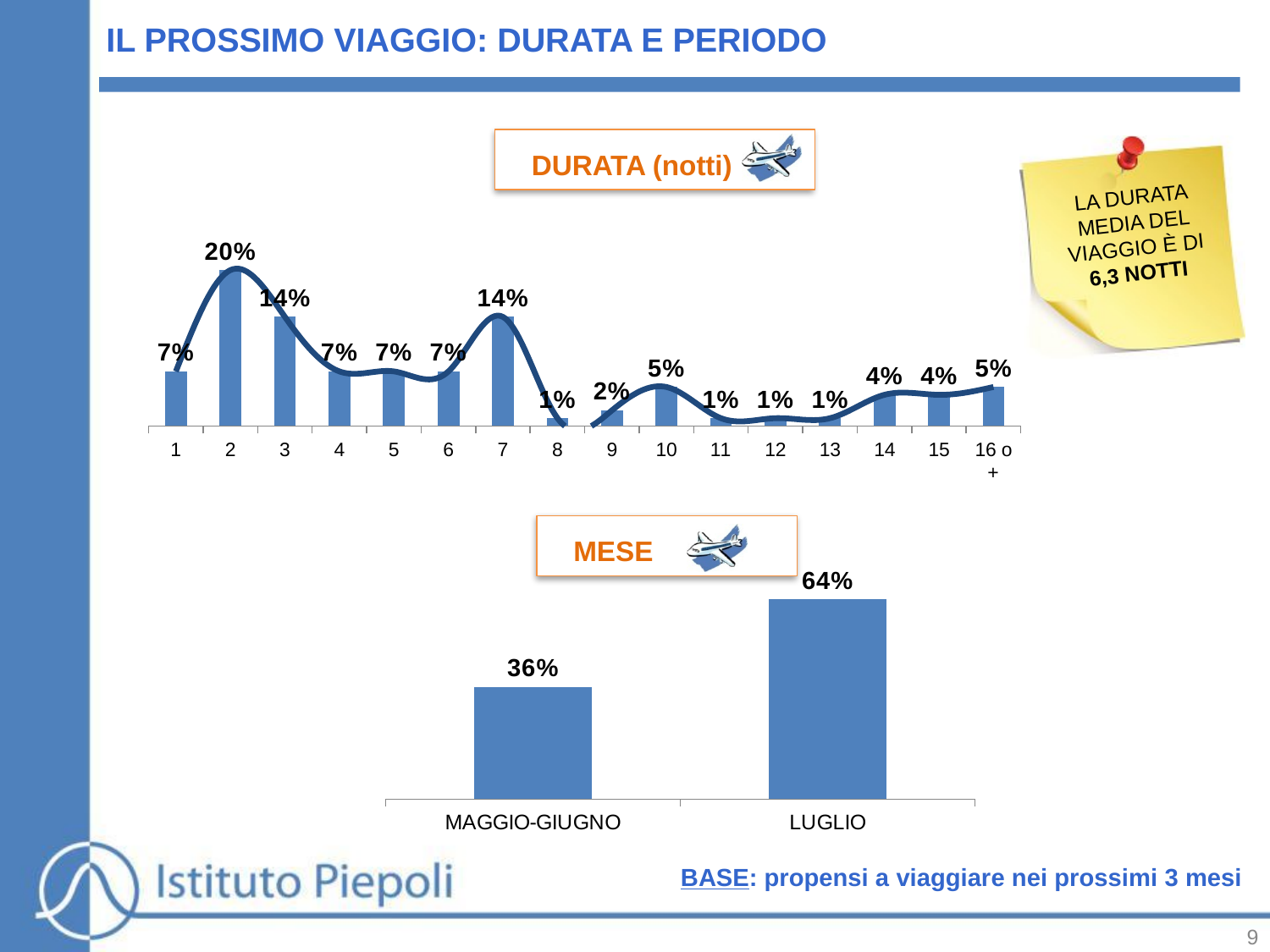
In the DURATA (notti) chart, what percentage corresponds to 2 nights? 20% In the DURATA (notti) chart, what percentage corresponds to 7 nights? 14% What kind of chart is the MESE chart? Bar chart In the MESE chart, what is the difference between LUGLIO and MAGGIO-GIUGNO? 28% In the MESE chart, what percentage corresponds to MAGGIO-GIUGNO? 36% In the DURATA (notti) chart, what percentage corresponds to the category '16 o +'? 5% In the DURATA (notti) chart, what is the difference between the values for 2 nights and 3 nights? 6% In the DURATA (notti) chart, which is larger: the value for 10 nights or the value for 14 nights? 10 nights How many categories are shown on the x axis of the DURATA (notti) chart? 16 According to the note on the slide, what is the average duration of the trip? 6,3 notti In the DURATA (notti) chart, which number of nights has the highest percentage? 2 In the MESE chart, what percentage corresponds to LUGLIO? 64%